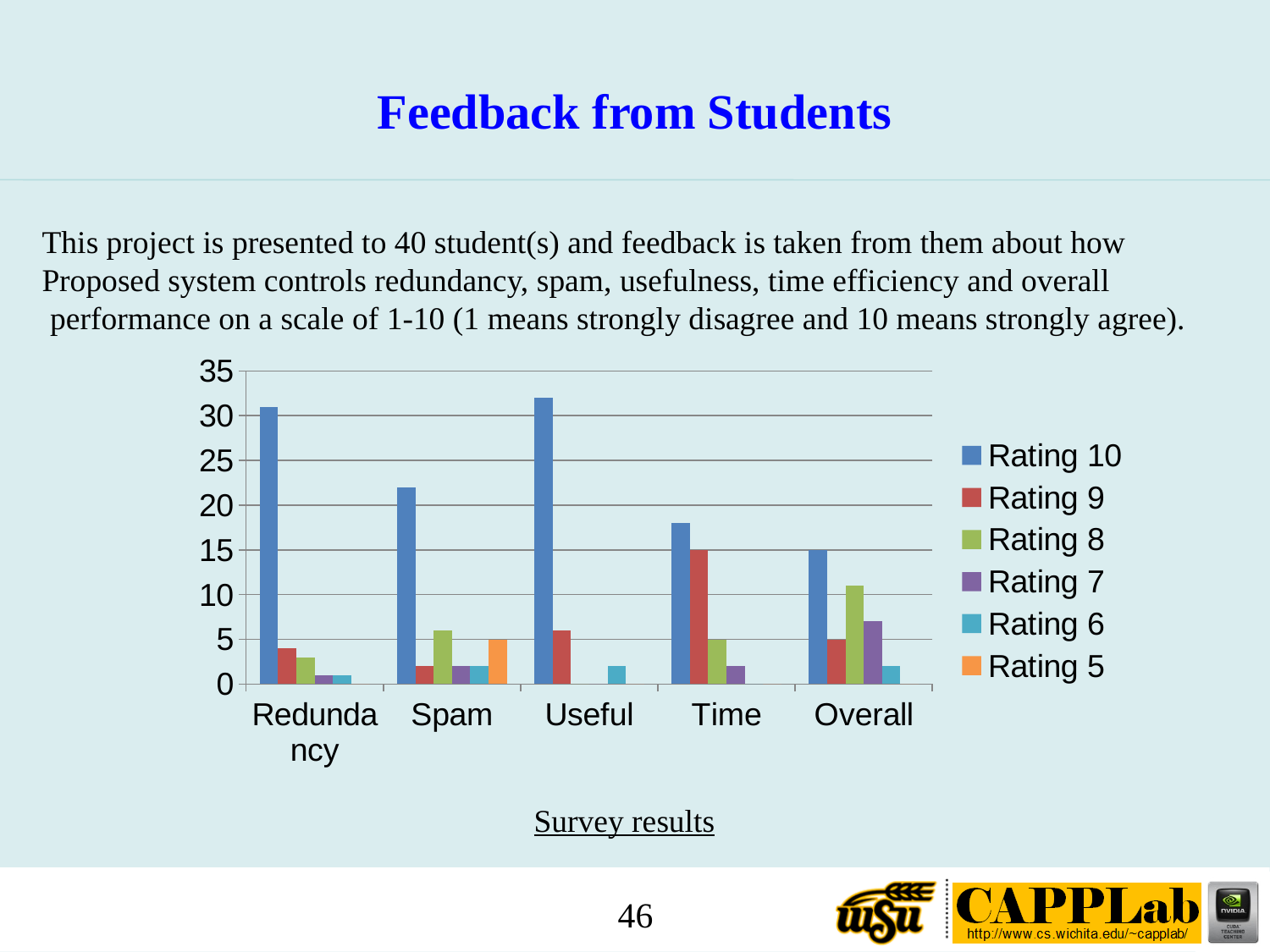
For the Time category, which is larger: the Rating 10 bar or the Rating 9 bar? Rating 10 For the Overall category, which is larger: the Rating 8 bar or the Rating 7 bar? Rating 8 What caption appears below the chart? Survey results Which category has the lowest Rating 10 bar? Overall How many series does the legend list? 6 Is the Rating 10 value for Spam greater or less than 20? greater Is the Rating 10 value for Redundancy greater or less than 30? greater Is the Rating 10 value for Time greater or less than 20? less What kind of chart is shown on the slide? bar chart Which category is the only one with a Rating 5 bar? Spam How many categories are shown on the x axis? 5